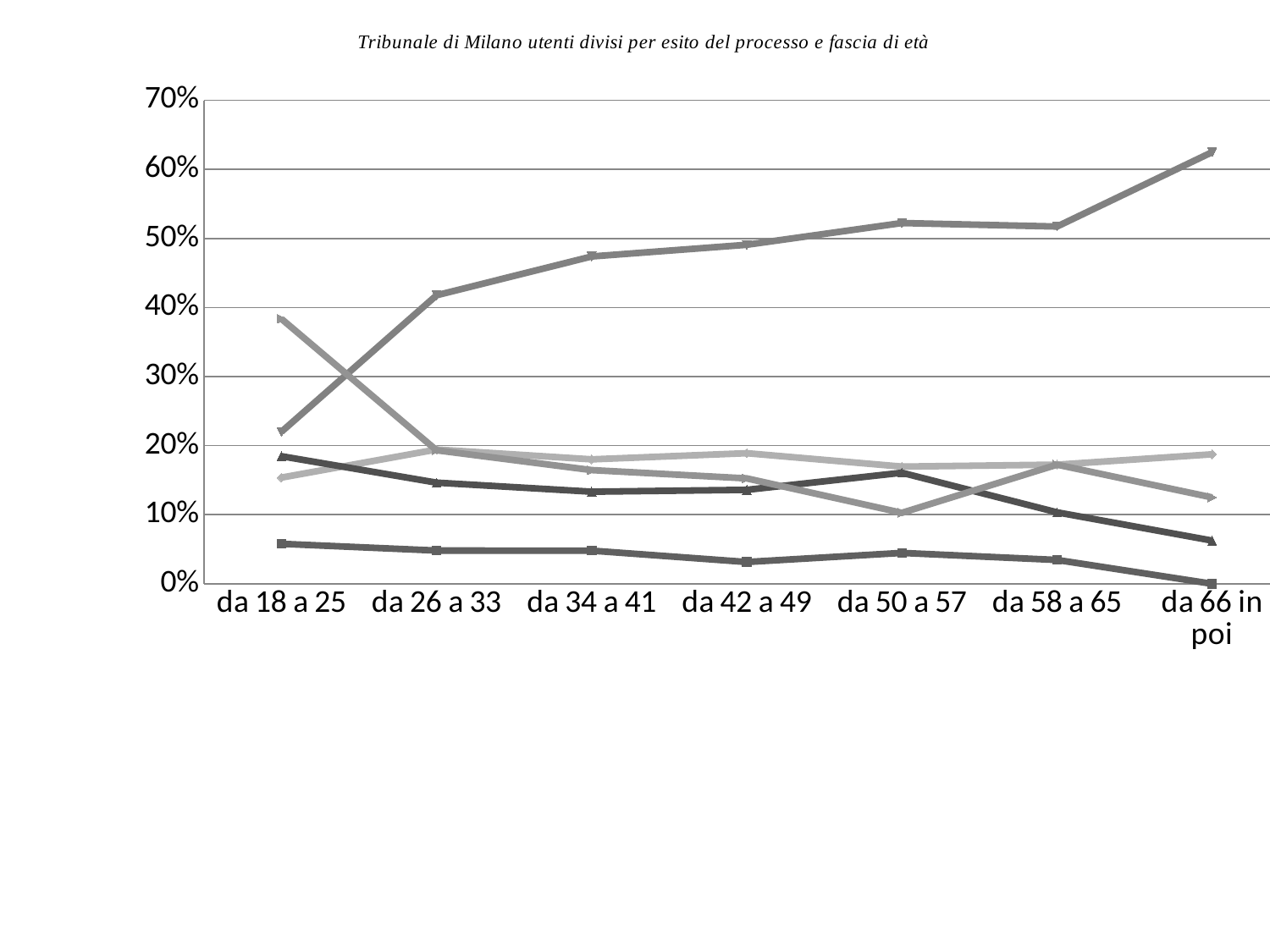
Is the highest plotted value at 'da 50 a 57' greater or less than 50%? greater Does the line that reaches the highest value at 'da 66 in poi' rise or fall overall from 'da 18 a 25' to 'da 66 in poi'? rise What is the title of the chart? Tribunale di Milano utenti divisi per esito del processo e fascia di età Is the lowest plotted value at 'da 18 a 25' greater or less than 10%? less At which age-group category does the chart reach its single highest plotted value? da 66 in poi What is the highest tick value shown on the y axis? 70% What kind of chart is shown on the slide? line chart Is the lowest plotted value at 'da 66 in poi' greater or less than 10%? less How many age-group categories are shown on the x axis? 7 Is the highest plotted value at 'da 18 a 25' larger or smaller than the highest plotted value at 'da 66 in poi'? smaller